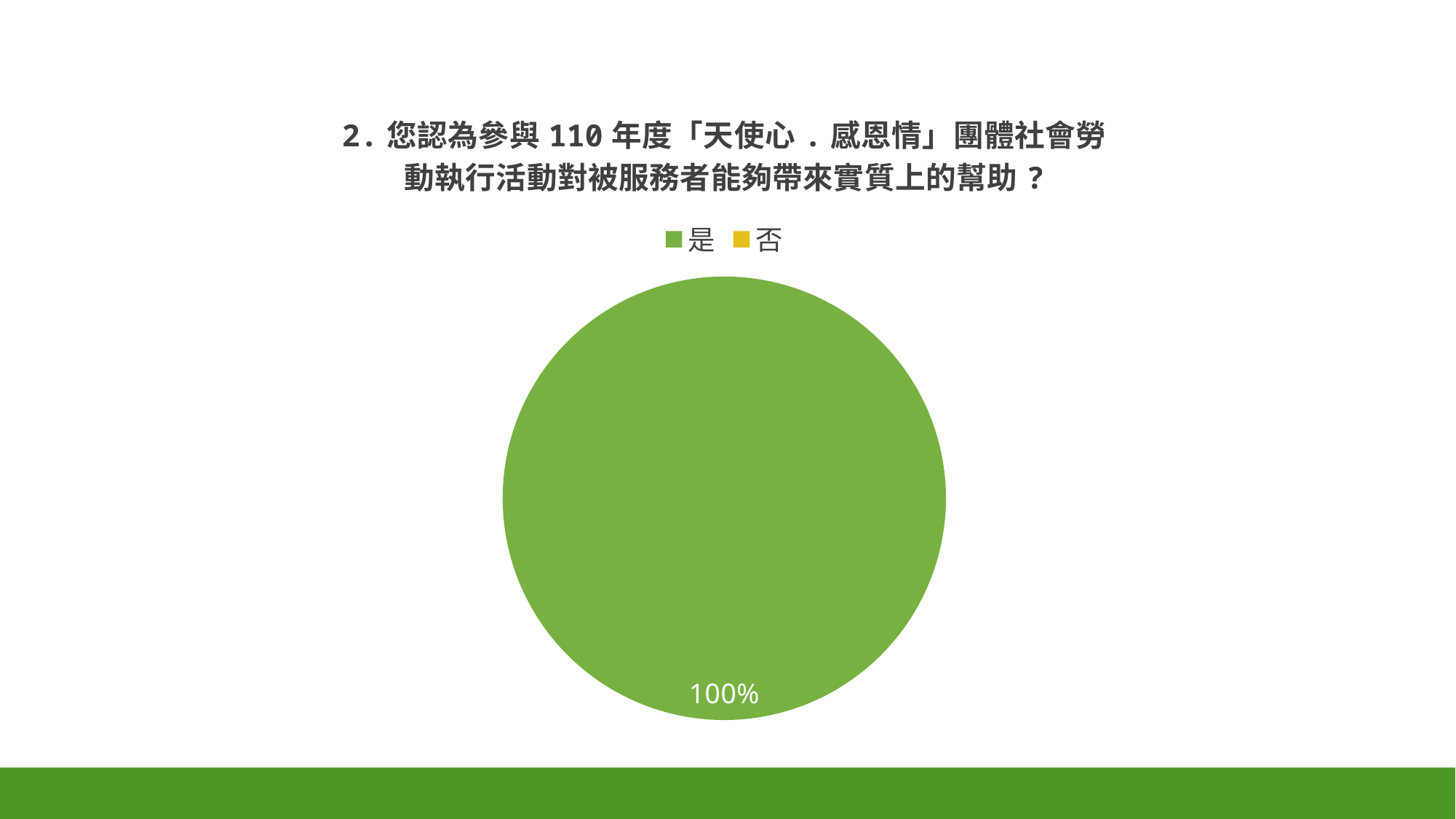
What is the data label printed on the pie slice? 100% What kind of chart is shown on the slide? pie chart What colour represents 是 in the legend? green What share of the pie does 是 take? 100% Which of 是 or 否 has the larger share of the pie? 是 Which category takes the largest share of the pie? 是 Is the share for 是 greater or less than 50%? greater How many entries does the legend list? 2 What colour represents 否 in the legend? yellow